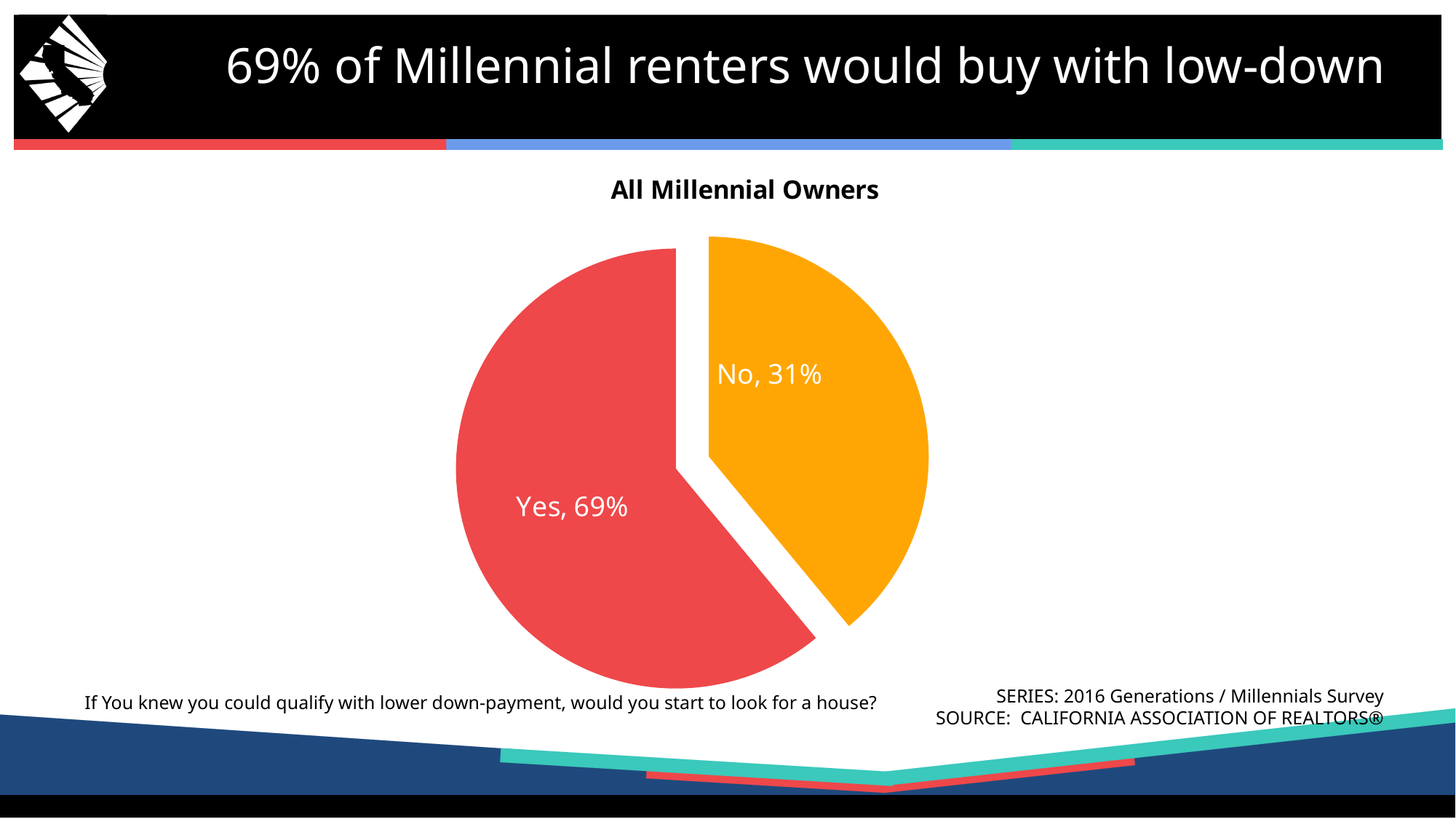
What is the difference in percentage points between the Yes and No slices? 38 What colour is the Yes slice? red Which slice is the smallest? No Which is larger, the Yes slice or the No slice? Yes How many slices does the pie chart have? 2 Is the value for Yes greater or less than 50%? greater What kind of chart is shown on the slide? pie chart Which slice is the largest? Yes What is the chart's title? All Millennial Owners What percentage of respondents answered No? 31% What share of the pie does the No slice represent? 31% What percentage of respondents answered Yes? 69%